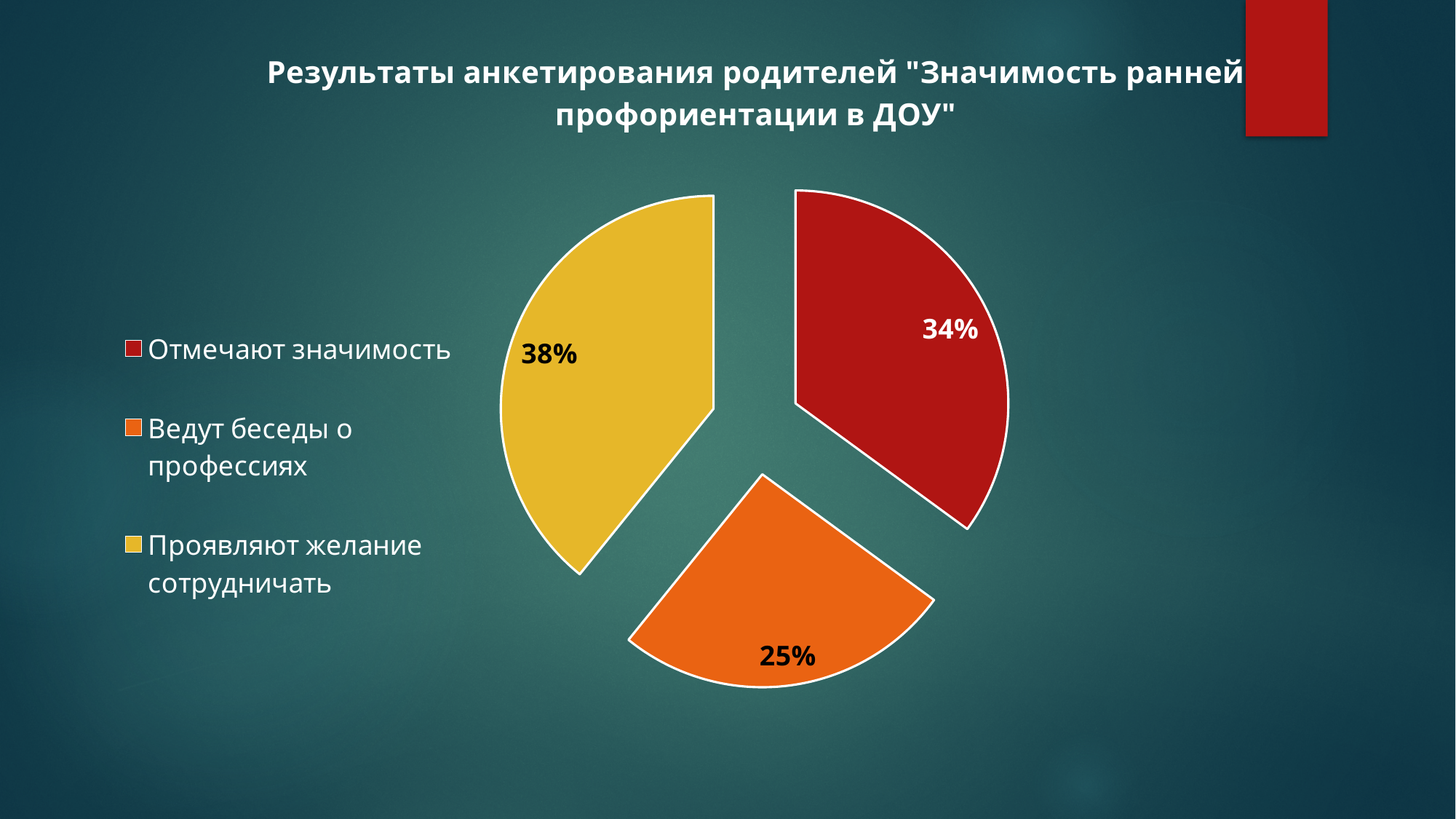
Which category has the smallest share of the pie? Ведут беседы о профессиях How many entries does the legend list? 3 Which is larger: the share for "Отмечают значимость" or the share for "Ведут беседы о профессиях"? Отмечают значимость What is the title of the chart? Результаты анкетирования родителей "Значимость ранней профориентации в ДОУ" Which category has the largest share of the pie? Проявляют желание сотрудничать What percentage is shown for "Ведут беседы о профессиях"? 25% What is the difference in percentage points between "Проявляют желание сотрудничать" and "Ведут беседы о профессиях"? 13 What colour is the slice for "Отмечают значимость"? Red How many slices does the pie chart have? 3 What percentage is shown for "Отмечают значимость"? 34% What percentage is shown for "Проявляют желание сотрудничать"? 38% What type of chart is shown on the slide? Pie chart